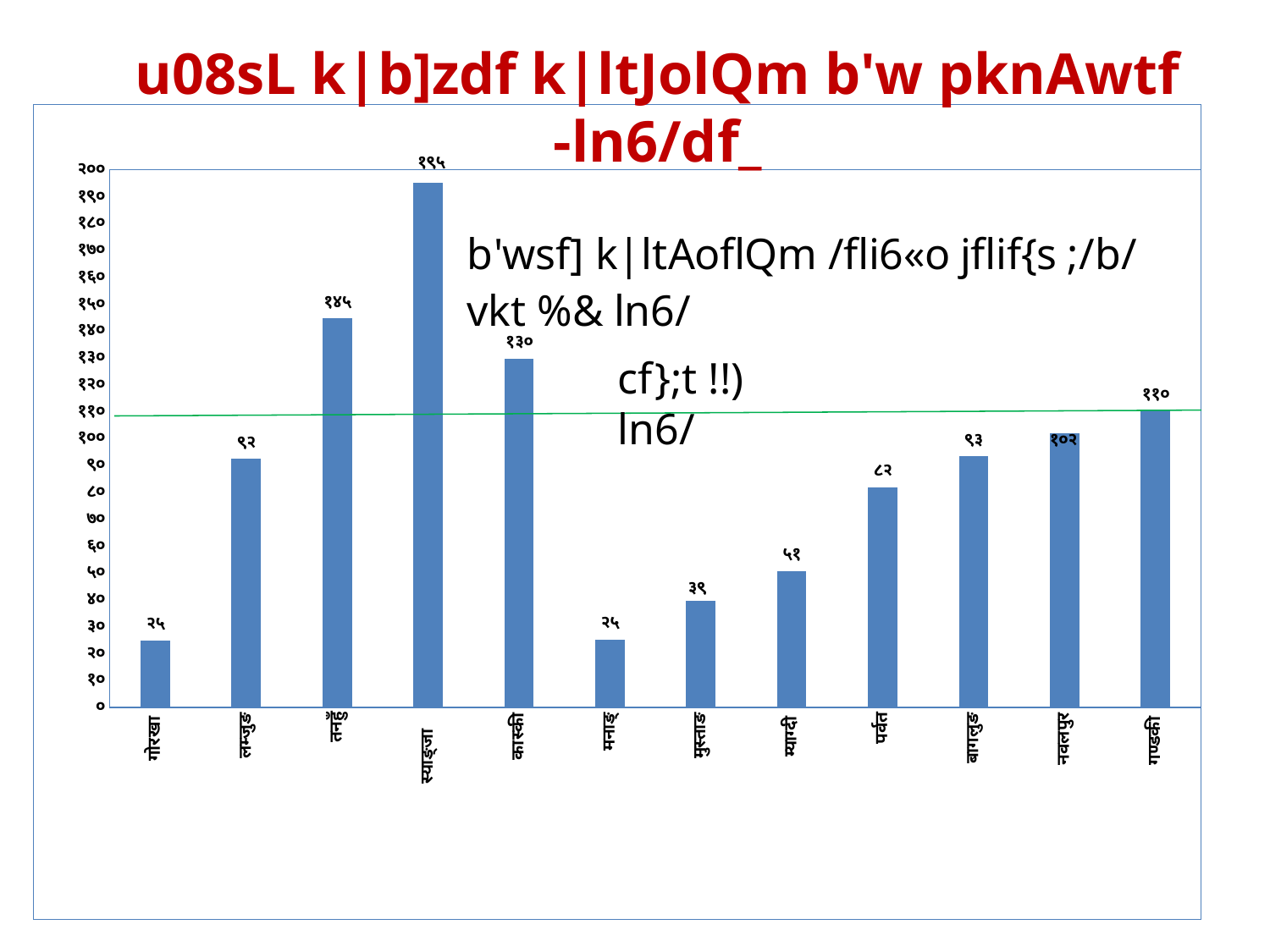
What kind of chart is shown on the slide? bar chart What is the value for नवलपुर? १०२ What is the value for कास्की? १३० Which is larger, the value for बागलुङ or the value for पर्वत? बागलुङ What is the value for स्याङ्जा? १९५ What is the value for तनहुँ? १४५ What is the difference between the values for कास्की and लम्जुङ? ३८ How many categories are shown on the x axis? 12 Which category has the highest value? स्याङ्जा Is the value for गण्डकी greater or less than १००? greater Which category has the lowest value, मुस्ताङ or म्याग्दी? मुस्ताङ What is the difference between the values for स्याङ्जा and तनहुँ? ५०